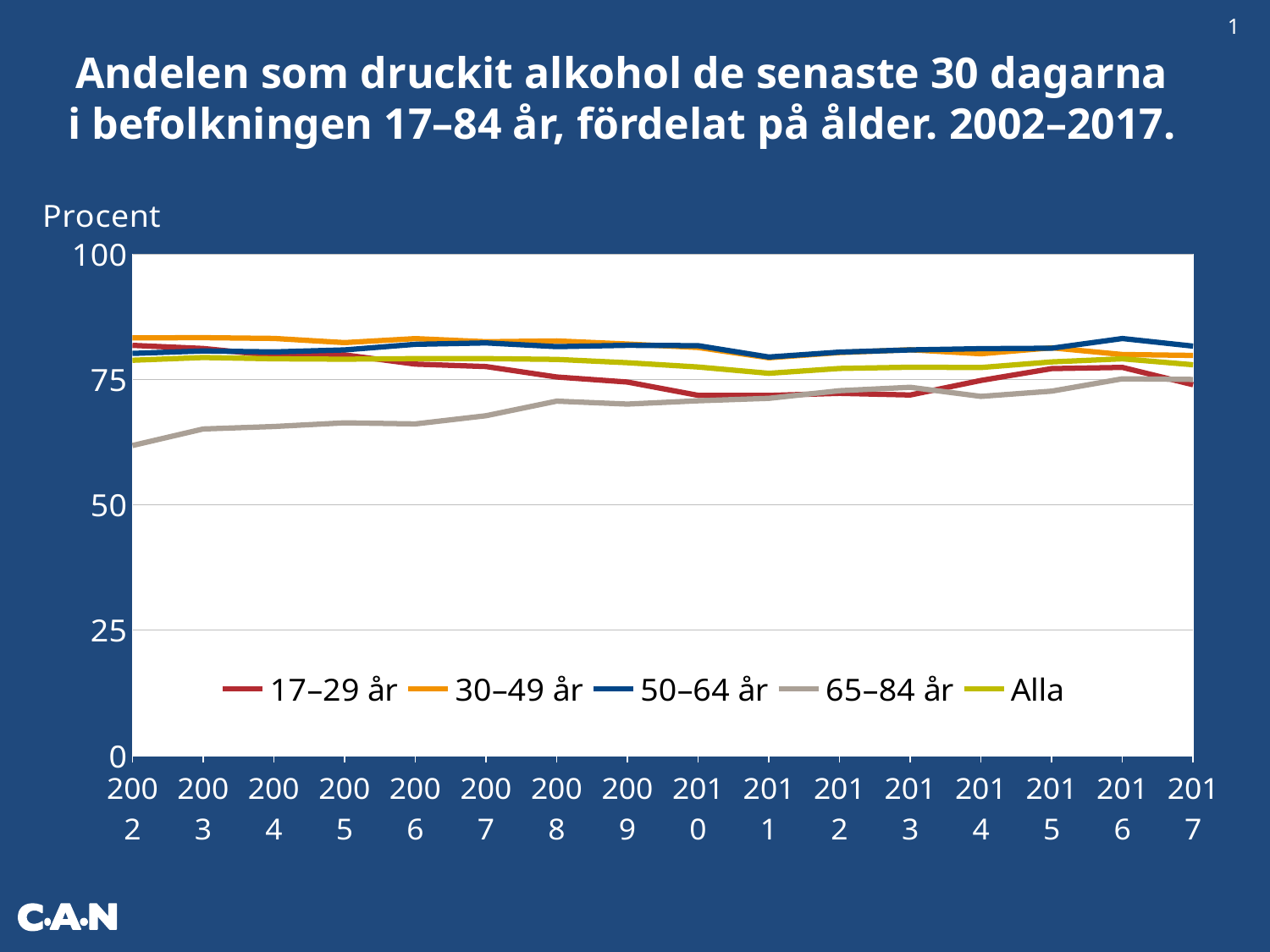
Does the line for 65–84 år generally rise or fall from 2002 to 2017? Rise What kind of chart is shown on the slide? Line chart Which is larger in 2002, the value for 50–64 år or the value for 65–84 år? 50–64 år Is the value for 50–64 år in 2016 greater or less than 75? greater Which age group has the lowest value in 2002? 65–84 år How many series does the legend list? 5 Is the value for 30–49 år in 2002 greater or less than 75? greater Is the value for 65–84 år in 2002 greater or less than 75? less How many years are plotted along the x axis? 16 Does the line for 17–29 år rise or fall between 2005 and 2010? Fall Which legend entry is drawn in grey? 65–84 år What label is shown on the vertical axis? Procent